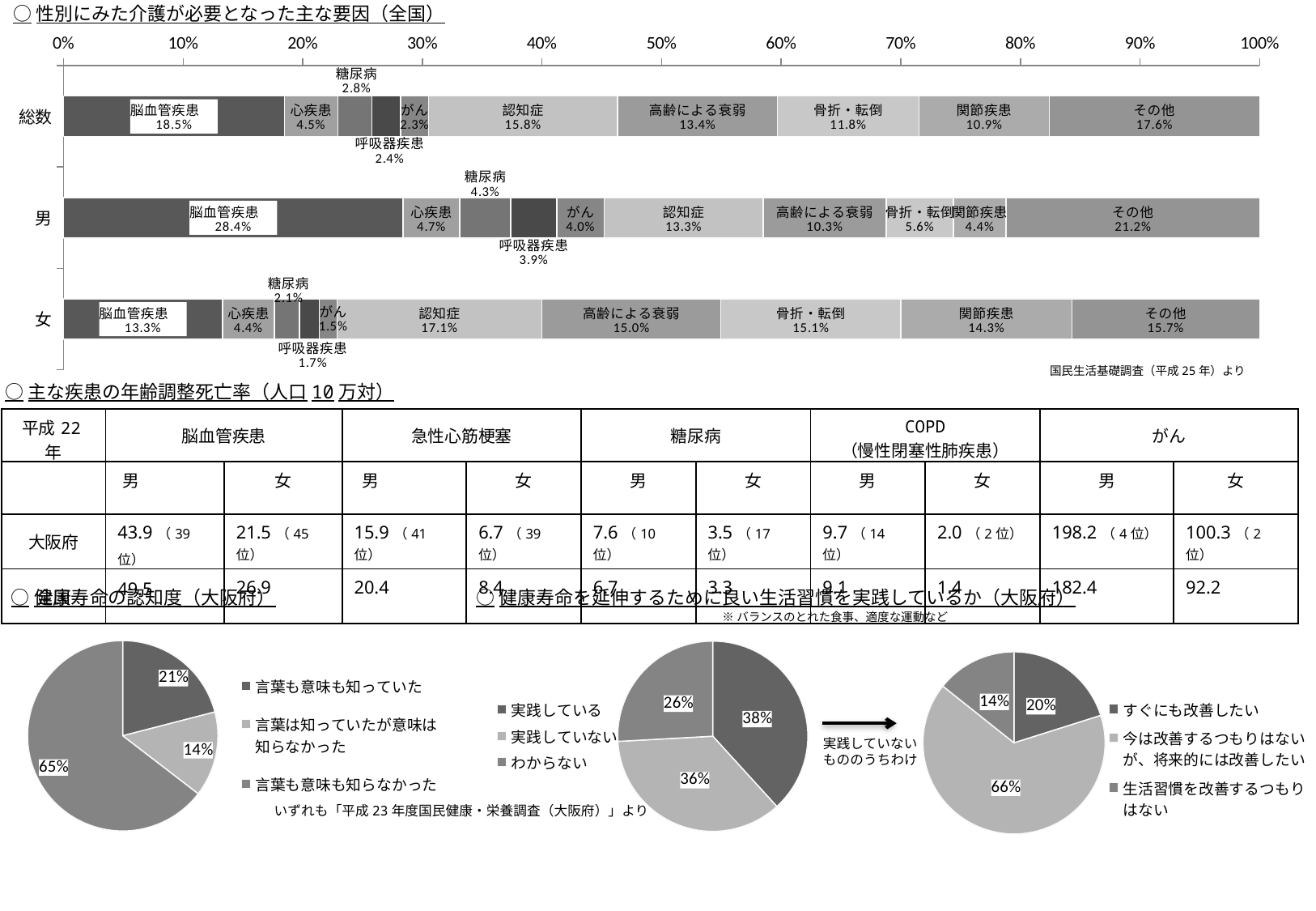
In the stacked bar chart 性別にみた介護が必要となった主な要因, which segment is the largest in the 男 bar? 脳血管疾患 In the rightmost pie chart (実践していないもののうちわけ), which slice is the largest? 今は改善するつもりはないが、将来的には改善したい In the pie chart 健康寿命の認知度（大阪府）, what share is 言葉も意味も知らなかった? 65% In the stacked bar chart 性別にみた介護が必要となった主な要因, what is the difference between the 脳血管疾患 values for 男 and 女? 15.1% In the stacked bar chart 性別にみた介護が必要となった主な要因, which is larger: 骨折・転倒 for 男 or 骨折・転倒 for 女? 女 In the stacked bar chart 性別にみた介護が必要となった主な要因, what is the value for 脳血管疾患 in the 男 bar? 28.4% How many bars (categories) does the stacked bar chart 性別にみた介護が必要となった主な要因 show? 3 What type of chart is 性別にみた介護が必要となった主な要因? Stacked bar chart In the pie chart 健康寿命を延伸するために良い生活習慣を実践しているか（大阪府）, what is the value for 実践している? 38% In the stacked bar chart 性別にみた介護が必要となった主な要因, what is the value for 認知症 in the 女 bar? 17.1% In the stacked bar chart 性別にみた介護が必要となった主な要因, which segment is the smallest in the 女 bar? がん In the stacked bar chart 性別にみた介護が必要となった主な要因, what is the value for 高齢による衰弱 in the 総数 bar? 13.4%